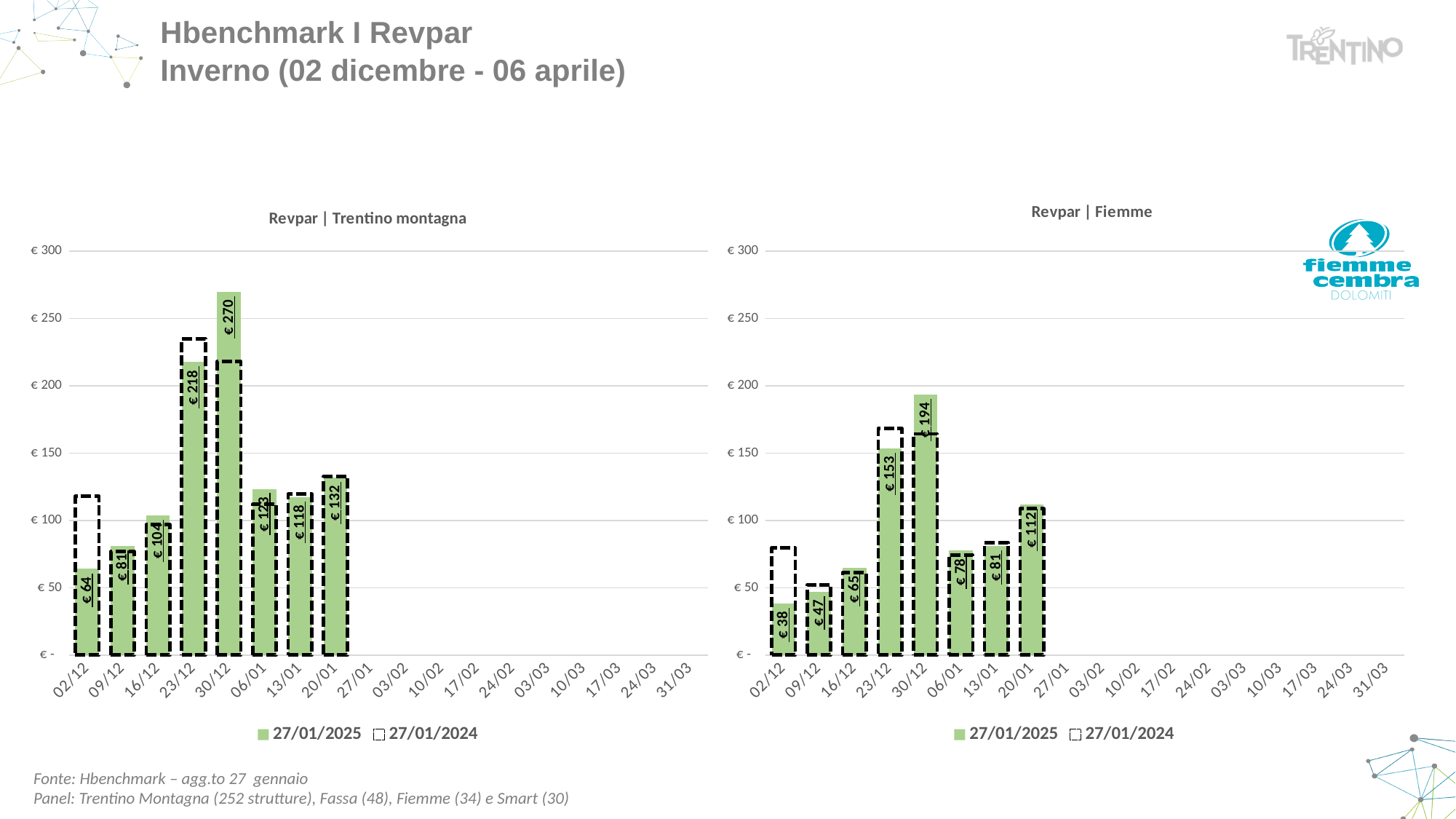
In the Revpar | Trentino montagna chart, which date has the highest 27/01/2025 value? 30/12 In the Revpar | Fiemme chart, which is larger for 27/01/2025: the value for 06/01 or the value for 20/01? 20/01 What kind of chart is the Revpar | Fiemme chart? Bar chart In the Revpar | Trentino montagna chart, what is the difference between the 27/01/2025 values for 30/12 and 23/12? € 52 In the Revpar | Fiemme chart, which date has the lowest 27/01/2025 value? 02/12 In the Revpar | Trentino montagna chart, is the 27/01/2024 value for 02/12 greater or less than € 100? greater In the Revpar | Fiemme chart, how many dates have a plotted 27/01/2025 bar? 8 In the Revpar | Fiemme chart, what is the 27/01/2025 value for 20/01? € 112 In the Revpar | Fiemme chart, what is the difference between the 27/01/2025 values for 30/12 and 23/12? € 41 In the Revpar | Trentino montagna chart, what is the 27/01/2025 value for 30/12? € 270 How many series does the legend of the Revpar | Trentino montagna chart list? 2 In the Revpar | Fiemme chart, is the 27/01/2024 value for 23/12 greater or less than € 150? greater